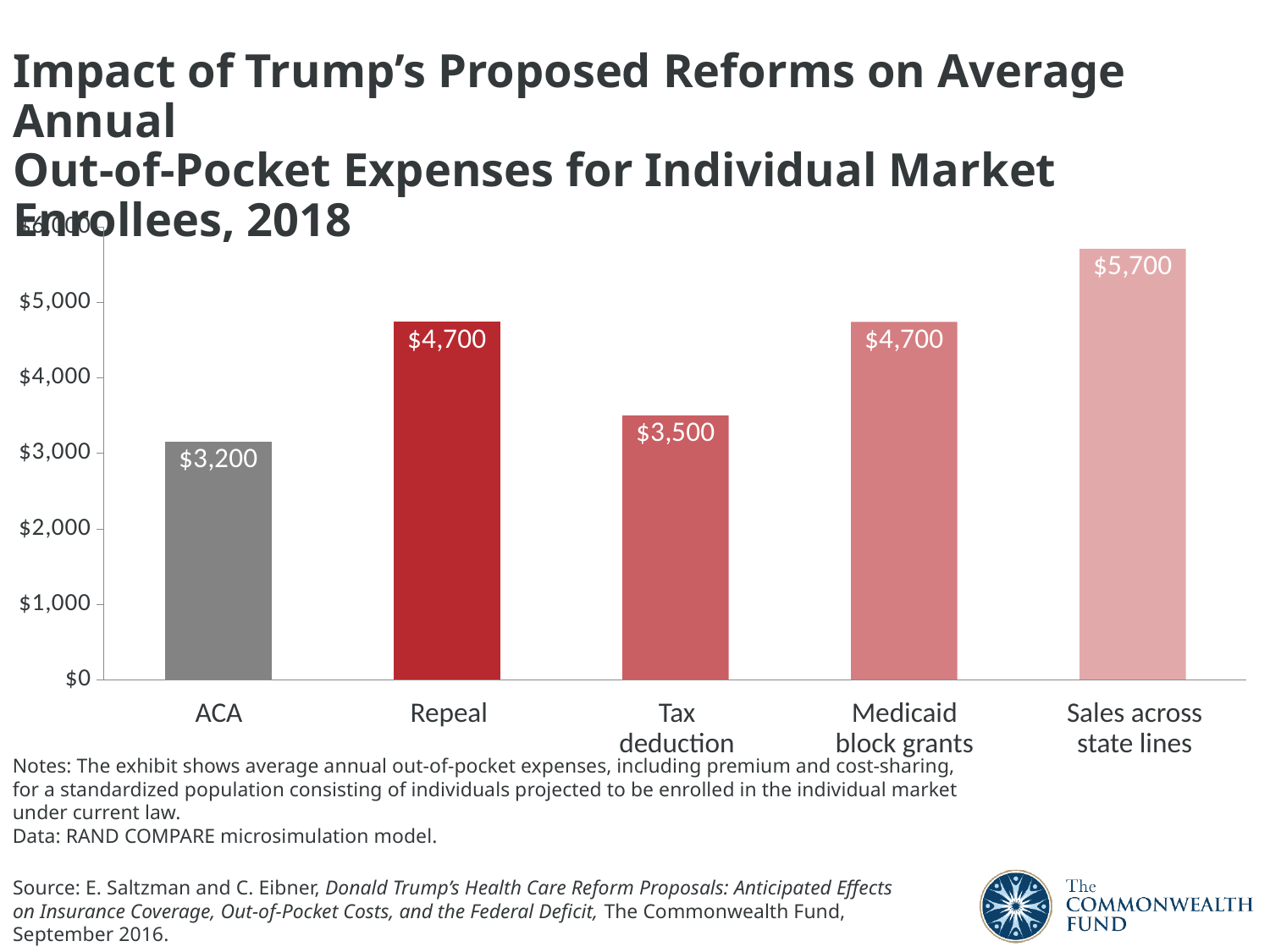
How many categories are shown on the x axis? 5 What is the value shown for Medicaid block grants? $4,700 Which category has the lowest out-of-pocket expense? ACA What data source is cited for the chart? RAND COMPARE microsimulation model What is the difference between the Sales across state lines value and the ACA value? $2,500 What kind of chart is shown on the slide? Bar chart What is the average annual out-of-pocket expense under the ACA? $3,200 Which is larger, the value for Repeal or the value for Tax deduction? Repeal What is the value shown for Sales across state lines? $5,700 What is the value shown for Tax deduction? $3,500 Which category has the highest out-of-pocket expense? Sales across state lines What is the difference between the Repeal value and the Tax deduction value? $1,200